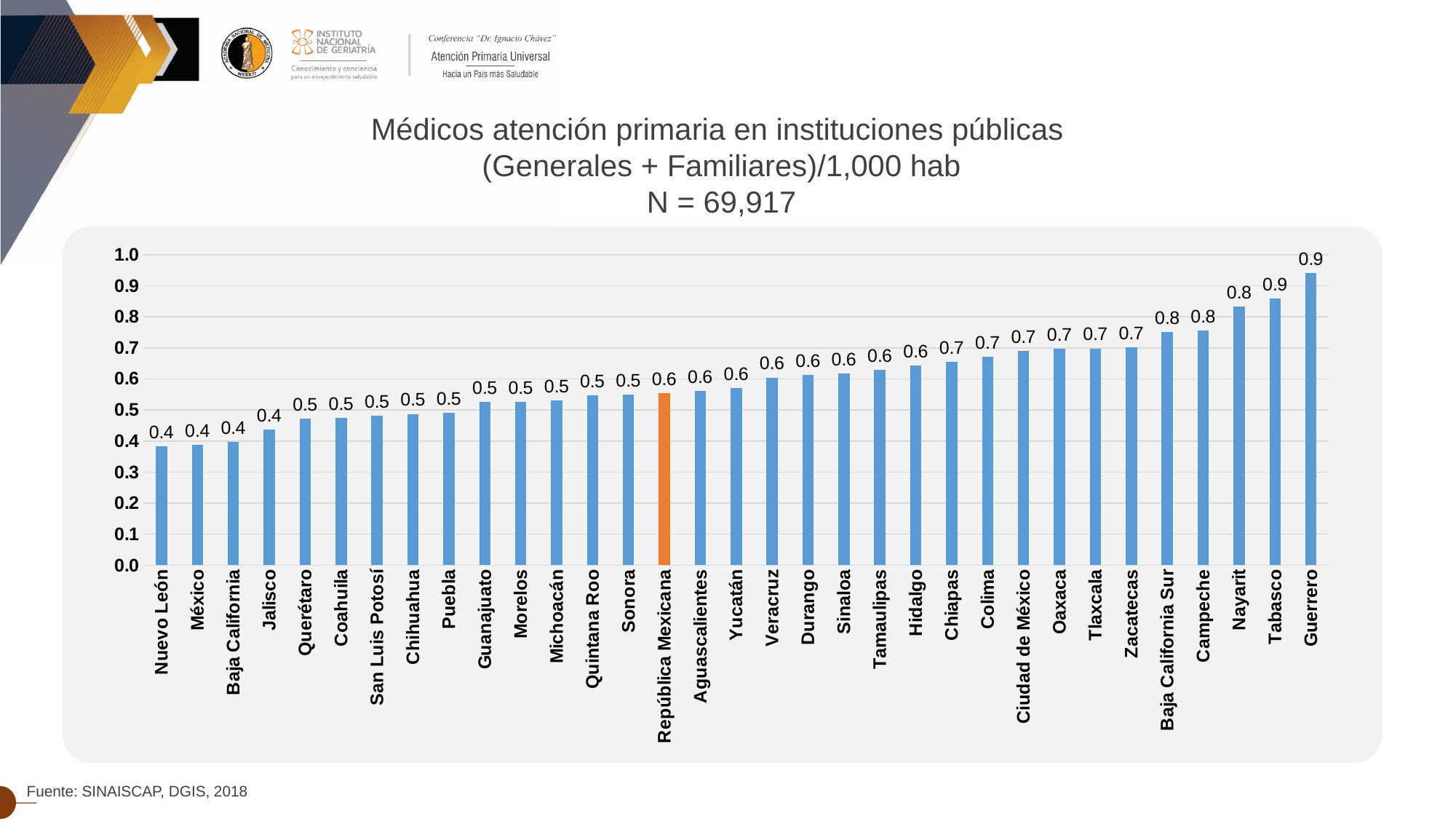
What is the value for República Mexicana? 0.6 What is the value for Guerrero? 0.9 What kind of chart is shown on the slide? bar chart Do the values rise or fall from left to right along the x axis? rise What is the value for Oaxaca? 0.7 How many categories are shown on the x axis? 33 Which category is shown with an orange bar instead of a blue one? República Mexicana What is the value for Nuevo León? 0.4 Which is larger, the value for Nayarit or the value for Campeche? Nayarit Which category has the highest value? Guerrero